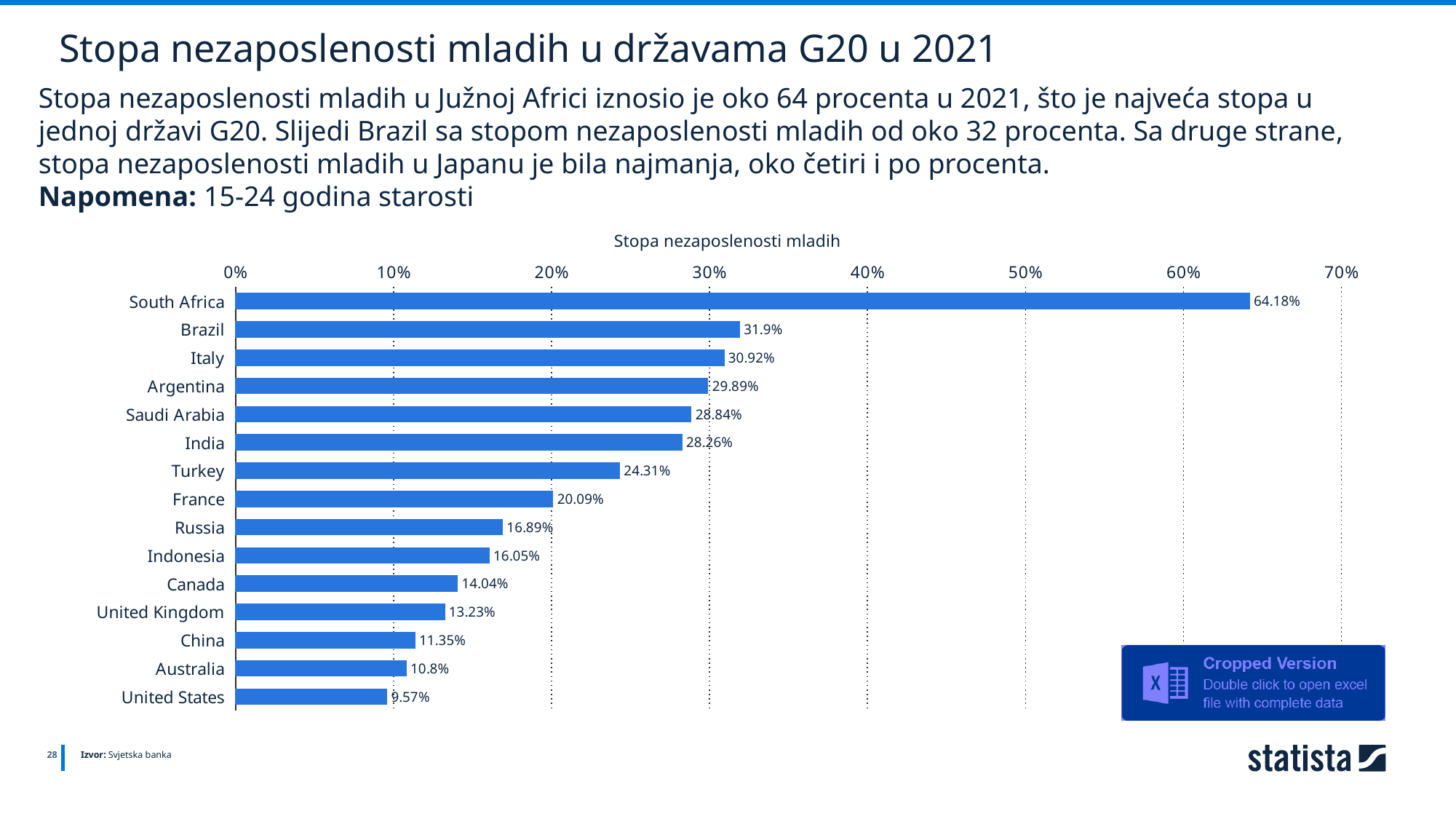
What is the value shown for the United States? 9.57% What is the value shown for Turkey? 24.31% What is the title of the chart? Stopa nezaposlenosti mladih Which has a higher youth unemployment rate, Russia or Indonesia? Russia What is the difference in percentage points between Turkey and France? 4.22 percentage points How many countries are shown on the chart? 15 What is the youth unemployment rate shown for Brazil? 31.9% What kind of chart is shown on the slide? Bar chart What is the difference in percentage points between South Africa and Brazil? 32.28 percentage points Which country has the lowest youth unemployment rate on the chart? United States Which country has the highest youth unemployment rate on the chart? South Africa Is the value for Italy greater or less than 30%? greater